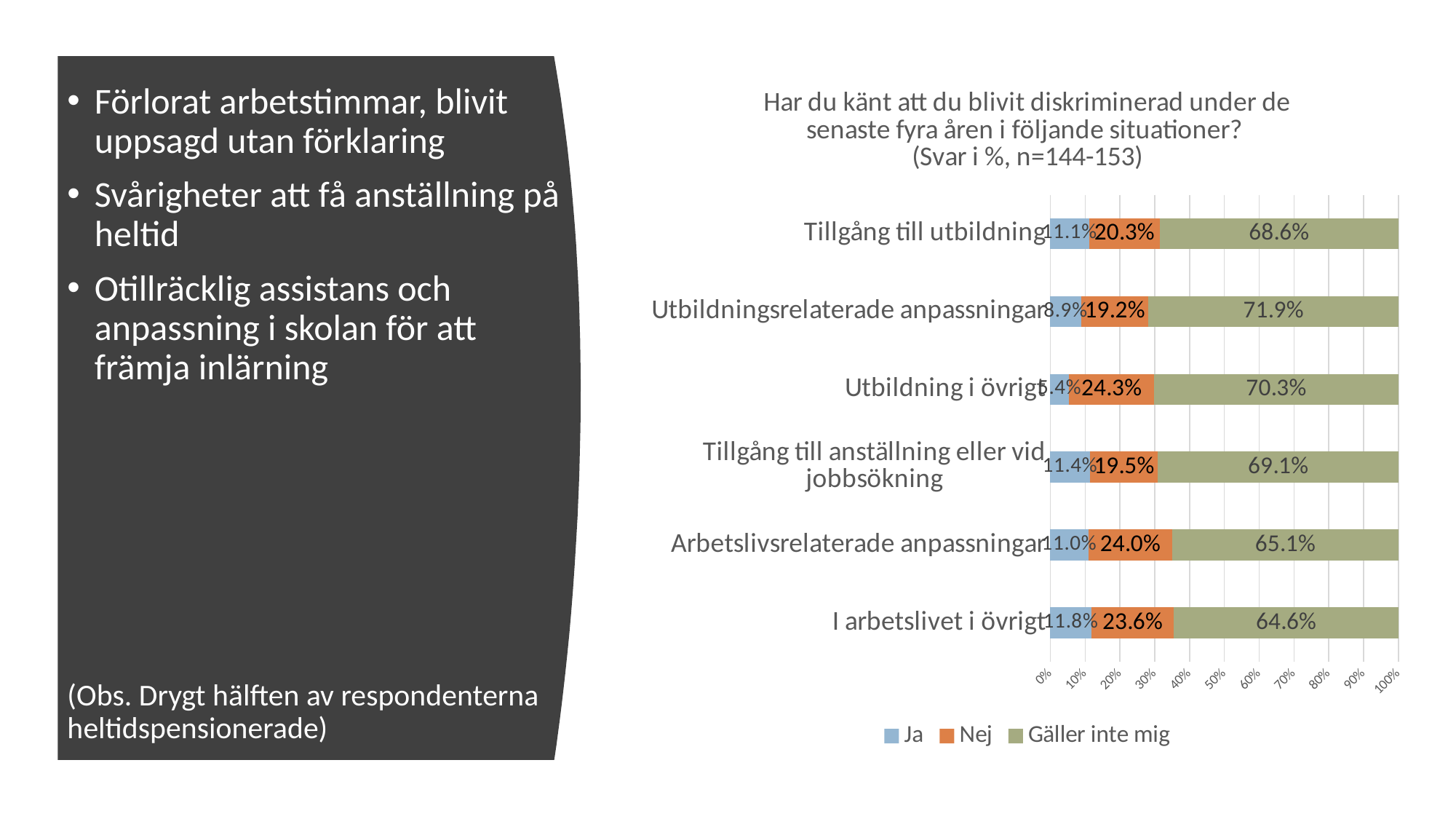
Which category has the highest 'Nej' value? Utbildning i övrigt What is the difference between the 'Nej' value for 'Arbetslivsrelaterade anpassningar' and the 'Nej' value for 'Tillgång till utbildning'? 3.7 percentage points Which category has the lowest 'Gäller inte mig' value? I arbetslivet i övrigt Which has the larger 'Nej' value: 'I arbetslivet i övrigt' or 'Tillgång till anställning eller vid jobbsökning'? I arbetslivet i övrigt What is the 'Gäller inte mig' value for 'Utbildningsrelaterade anpassningar'? 71.9% What kind of chart is shown on the slide? Bar chart Which category has the highest 'Gäller inte mig' value? Utbildningsrelaterade anpassningar How many series does the legend of the chart list? 3 What is the 'Ja' value for 'I arbetslivet i övrigt'? 11.8% How many categories (situations) are shown on the chart? 6 What is the 'Nej' value for 'Utbildning i övrigt'? 24.3% What are the three legend entries of the chart? Ja, Nej, Gäller inte mig